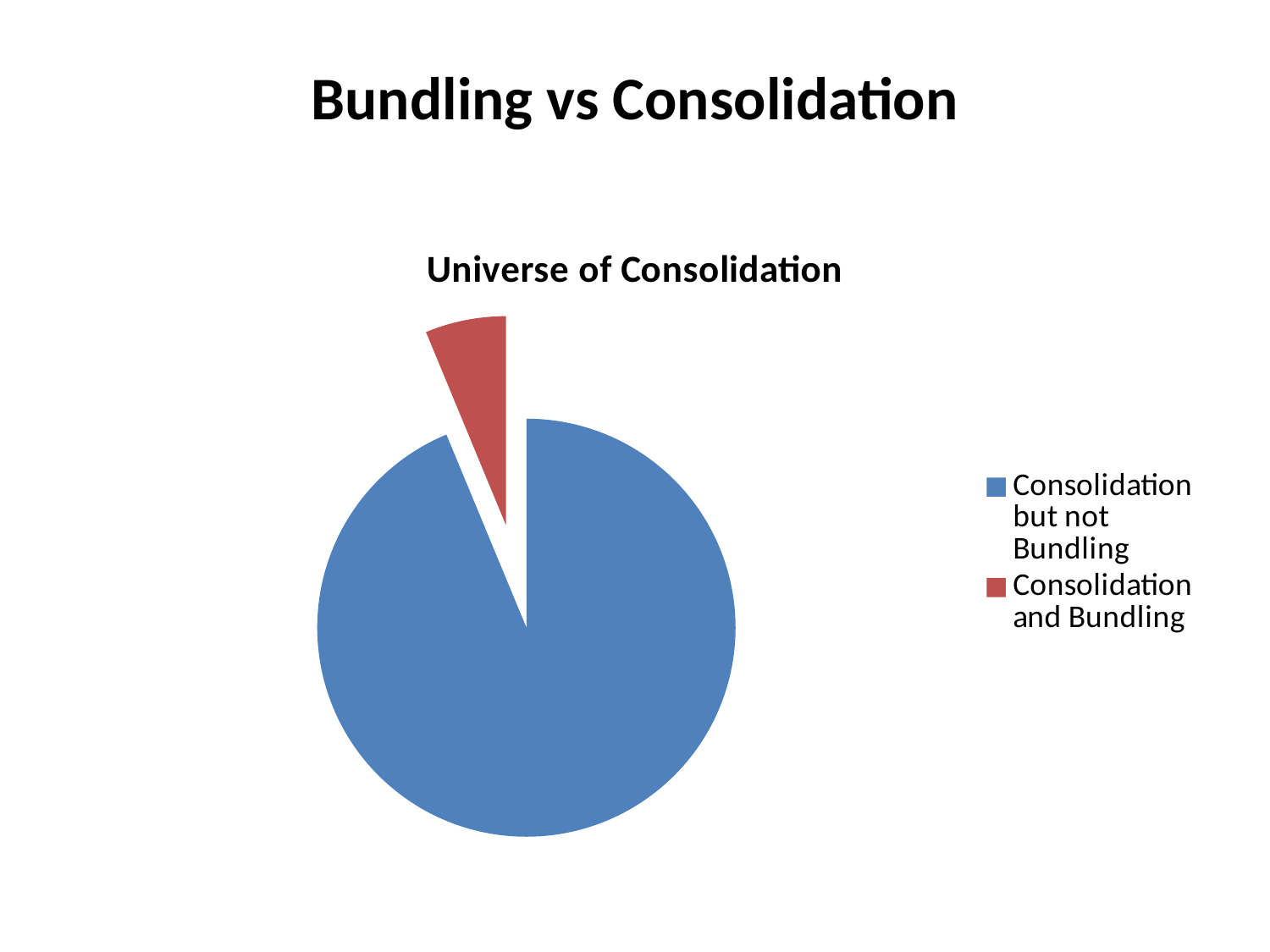
Is the share of the pie for Consolidation and Bundling greater or less than 25%? less Which slice is the largest in the pie chart? Consolidation but not Bundling Which slice is the smallest in the pie chart? Consolidation and Bundling What colour is the slice for Consolidation and Bundling? red What is the title of the chart? Universe of Consolidation Is the share of the pie for Consolidation but not Bundling greater or less than 50%? greater Which is larger: the slice for Consolidation but not Bundling or the slice for Consolidation and Bundling? Consolidation but not Bundling What kind of chart is shown on the slide? pie chart How many entries does the legend list? 2 How many slices does the pie chart have? 2